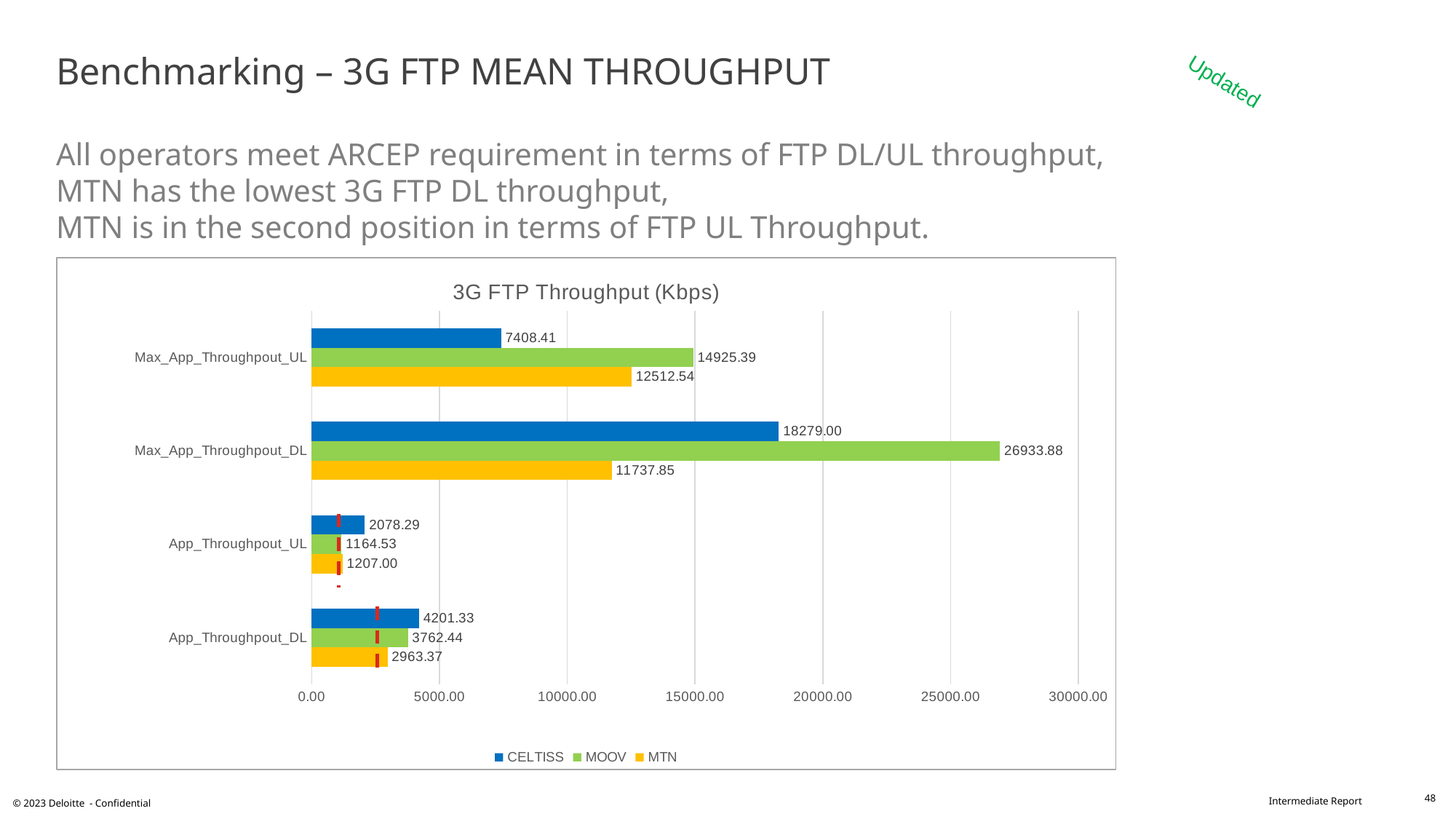
What is the value for CELTISS in the Max_App_Throughpout_UL category? 7408.41 What is the value for MOOV in the Max_App_Throughpout_DL category? 26933.88 Which operator has the lowest value in the Max_App_Throughpout_DL category? MTN What is the title of the chart? 3G FTP Throughput (Kbps) How many series does the legend list? 3 Which operator has the highest value in the App_Throughpout_UL category? CELTISS How many categories are shown on the y axis of the chart? 4 What kind of chart is shown on the slide? Bar chart What is the value for MTN in the App_Throughpout_DL category? 2963.37 What is the difference between the MOOV and MTN values in the Max_App_Throughpout_UL category? 2412.85 Is the value for CELTISS in the Max_App_Throughpout_DL category greater or less than 15000.00? greater Which is larger in the App_Throughpout_DL category, the CELTISS value or the MOOV value? CELTISS